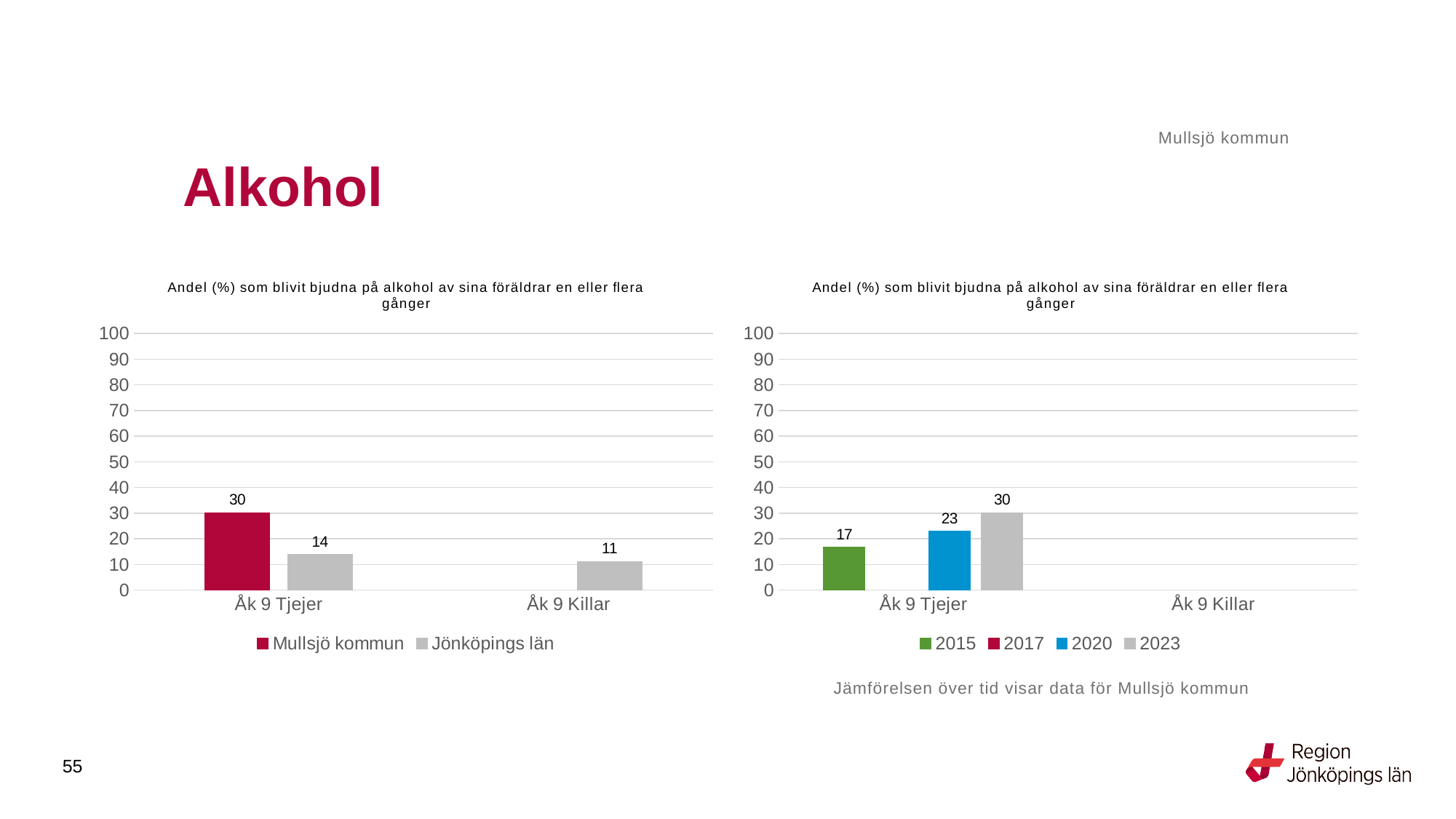
In the right chart, do the values for Åk 9 Tjejer rise or fall from 2015 to 2023? rise In the left chart, what is the value for Jönköpings län for Åk 9 Killar? 11 In the right chart, what is the value for 2015 for Åk 9 Tjejer? 17 In the left chart, how many series does the legend list? 2 In the left chart, what is the difference between Mullsjö kommun and Jönköpings län for Åk 9 Tjejer? 16 In the left chart, what is the value for Jönköpings län for Åk 9 Tjejer? 14 In the right chart, what is the value for 2023 for Åk 9 Tjejer? 30 In the right chart, which year has the highest value for Åk 9 Tjejer? 2023 What kind of chart is the right chart? bar chart In the right chart, what is the value for 2020 for Åk 9 Tjejer? 23 In the left chart, what is the value for Mullsjö kommun for Åk 9 Tjejer? 30 In the left chart, which series has the higher value for Åk 9 Tjejer, Mullsjö kommun or Jönköpings län? Mullsjö kommun